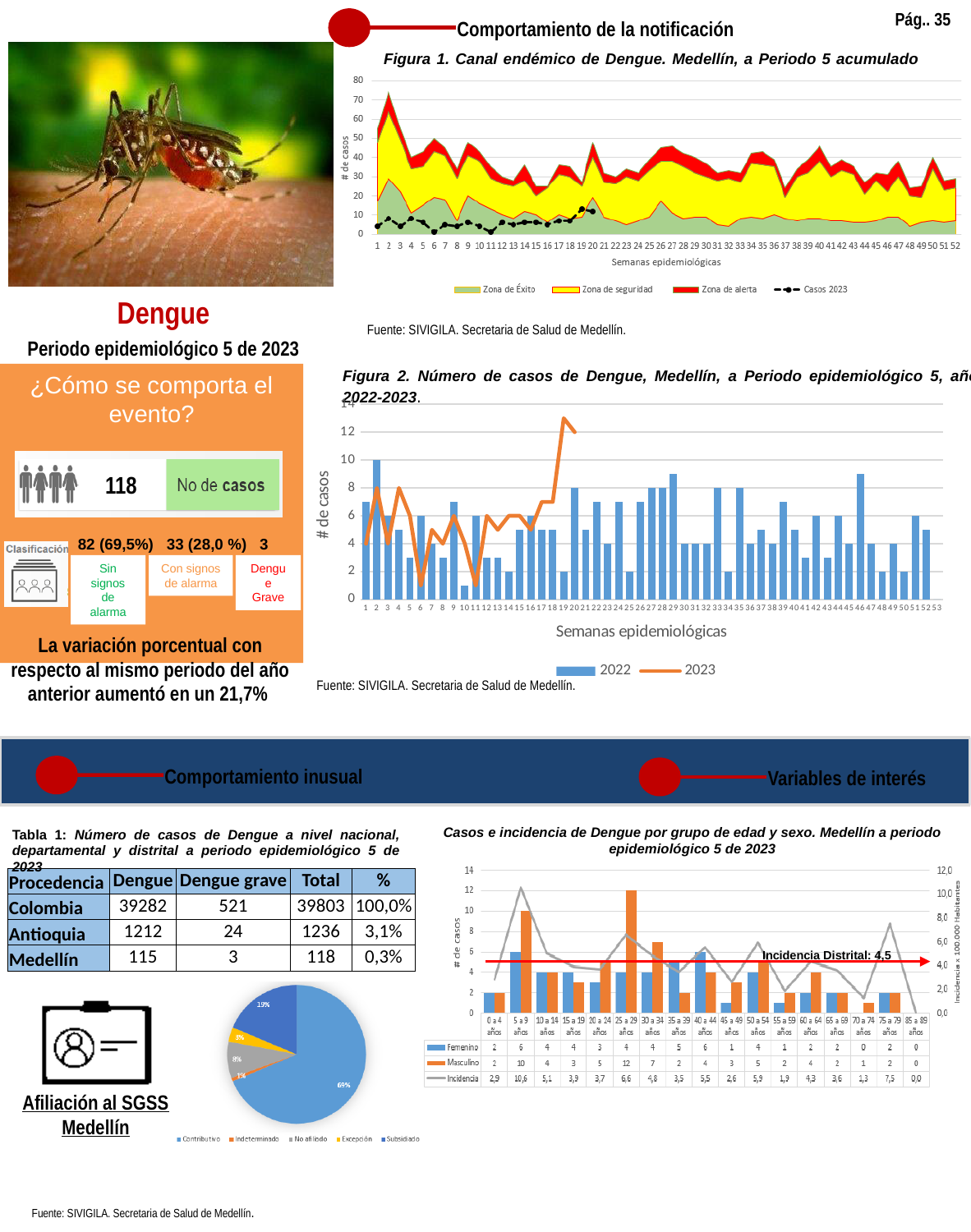
In Figura 2, is the 2022 value for week 2 greater or less than 8? greater In the chart 'Casos e incidencia de Dengue por grupo de edad y sexo', how many series does the legend list? 3 In the chart 'Casos e incidencia de Dengue por grupo de edad y sexo', what is the Masculino value for the 25 a 29 años age group? 12 In the chart 'Casos e incidencia de Dengue por grupo de edad y sexo', what is the Incidencia value for the 5 a 9 años age group? 10,6 In Figura 1, how many entries does the legend list? 4 In the chart 'Casos e incidencia de Dengue por grupo de edad y sexo', what is the value of the Incidencia Distrital reference line? 4,5 In the chart 'Casos e incidencia de Dengue por grupo de edad y sexo', what is the difference between the Masculino and Femenino values for the 5 a 9 años age group? 4 In the pie chart 'Afiliación al SGSS Medellín', what is the share of the largest slice? 69% What kind of chart is used for 'Afiliación al SGSS Medellín'? Pie chart In the chart 'Casos e incidencia de Dengue por grupo de edad y sexo', which is larger for the 40 a 44 años group, Femenino or Masculino? Femenino In the chart 'Casos e incidencia de Dengue por grupo de edad y sexo', which age group has the highest Masculino value? 25 a 29 años In Figura 2, how many series does the legend list? 2